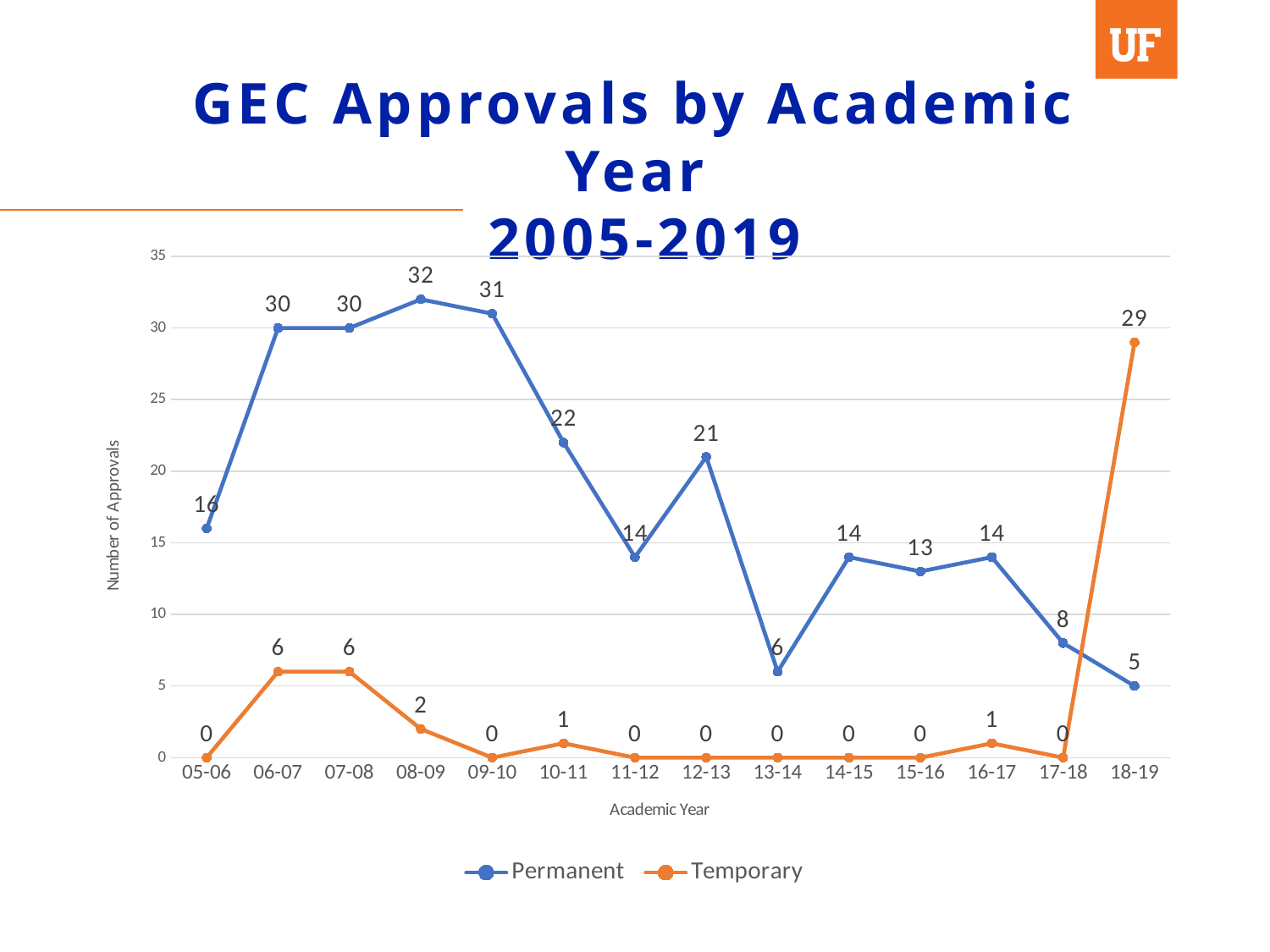
What is the number of Permanent approvals in 08-09? 32 What is the label of the y axis? Number of Approvals Which academic year has the highest number of Permanent approvals? 08-09 What is the number of Temporary approvals in 18-19? 29 What kind of chart is shown on the slide? Line chart How many academic years are shown on the x axis? 14 How many series does the legend list? 2 What is the difference between Permanent and Temporary approvals in 18-19? 24 Which is larger in 13-14, Permanent approvals or Temporary approvals? Permanent Do Permanent approvals rise or fall from 09-10 to 11-12? Fall Which academic year has the lowest number of Permanent approvals? 18-19 What is the number of Temporary approvals in 06-07? 6